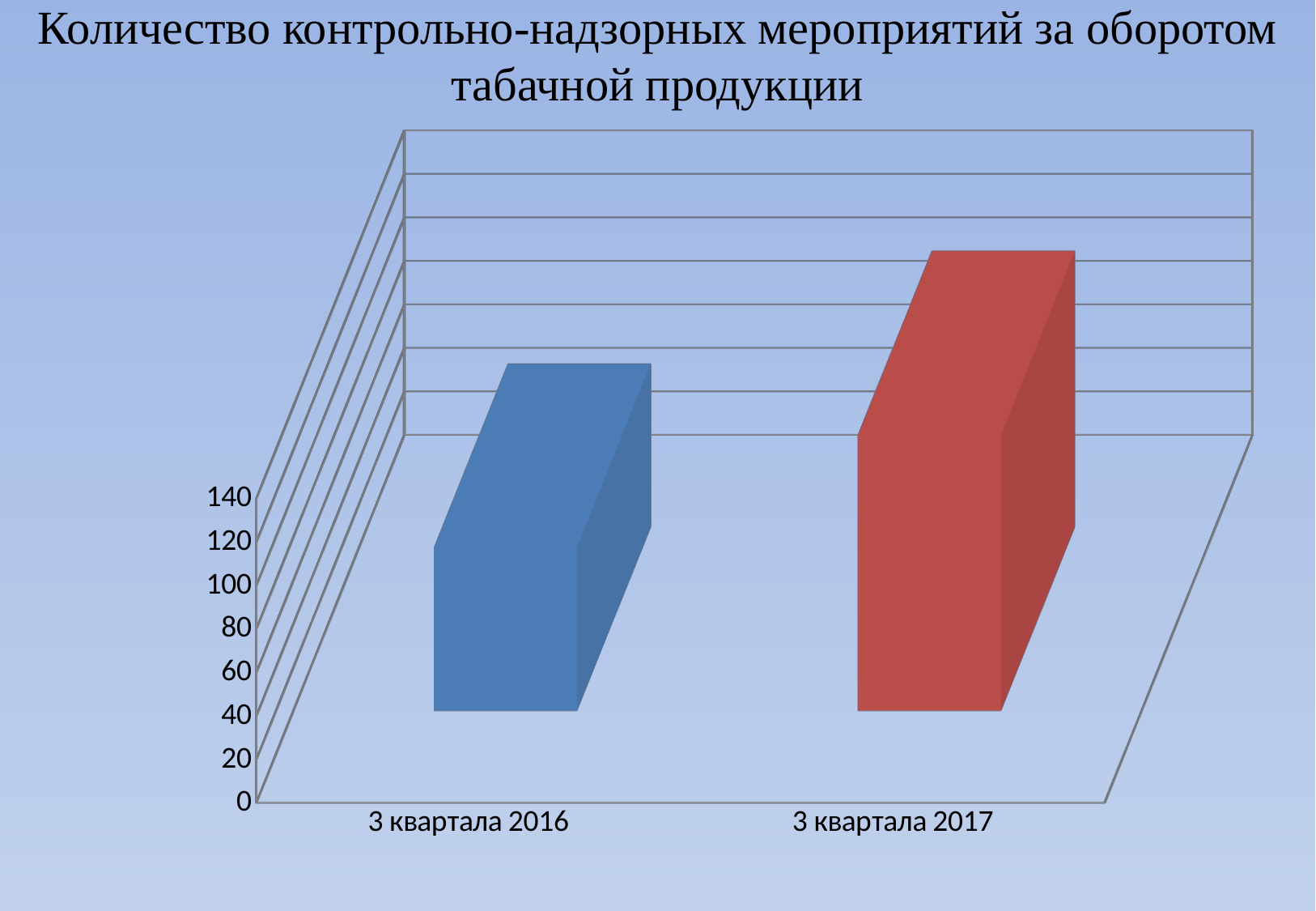
Which is larger: the value for 3 квартала 2016 or the value for 3 квартала 2017? 3 квартала 2017 Which category has the lowest value in the chart? 3 квартала 2016 Is the value for 3 квартала 2017 greater or less than 80? greater Is the value for 3 квартала 2016 greater or less than 100? less What colour is the bar for 3 квартала 2017? red How many categories are shown on the x axis of the chart? 2 Which category has the highest value in the chart? 3 квартала 2017 What kind of chart is shown on the slide? bar chart Is the value for 3 квартала 2016 greater or less than 40? greater What is the title of the chart on the slide? Количество контрольно-надзорных мероприятий за оборотом табачной продукции Do the values rise or fall from 3 квартала 2016 to 3 квартала 2017? rise